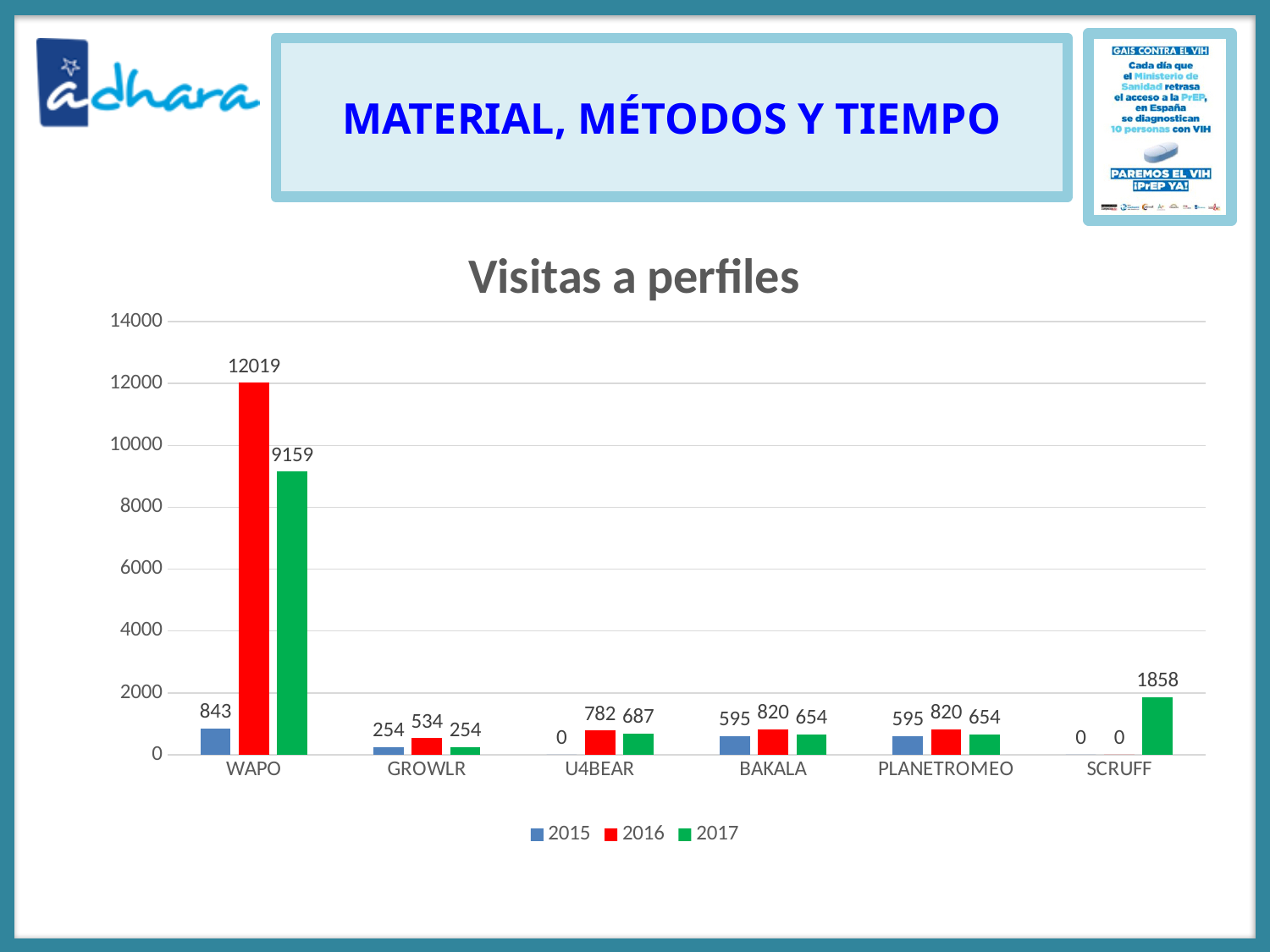
What is the value for GROWLR in 2016? 534 What is the value for SCRUFF in 2017? 1858 How many series does the legend list? 3 What is the title of the chart? Visitas a perfiles What is the value for WAPO in 2016? 12019 Which is larger for BAKALA, the 2015 value or the 2017 value? 2017 What kind of chart is shown? bar chart Which category has the lowest value in 2016? SCRUFF What is the value for U4BEAR in 2015? 0 What is the difference between the 2016 and 2017 values for WAPO? 2860 Which category has the highest value in 2017? WAPO How many categories are shown on the x axis? 6